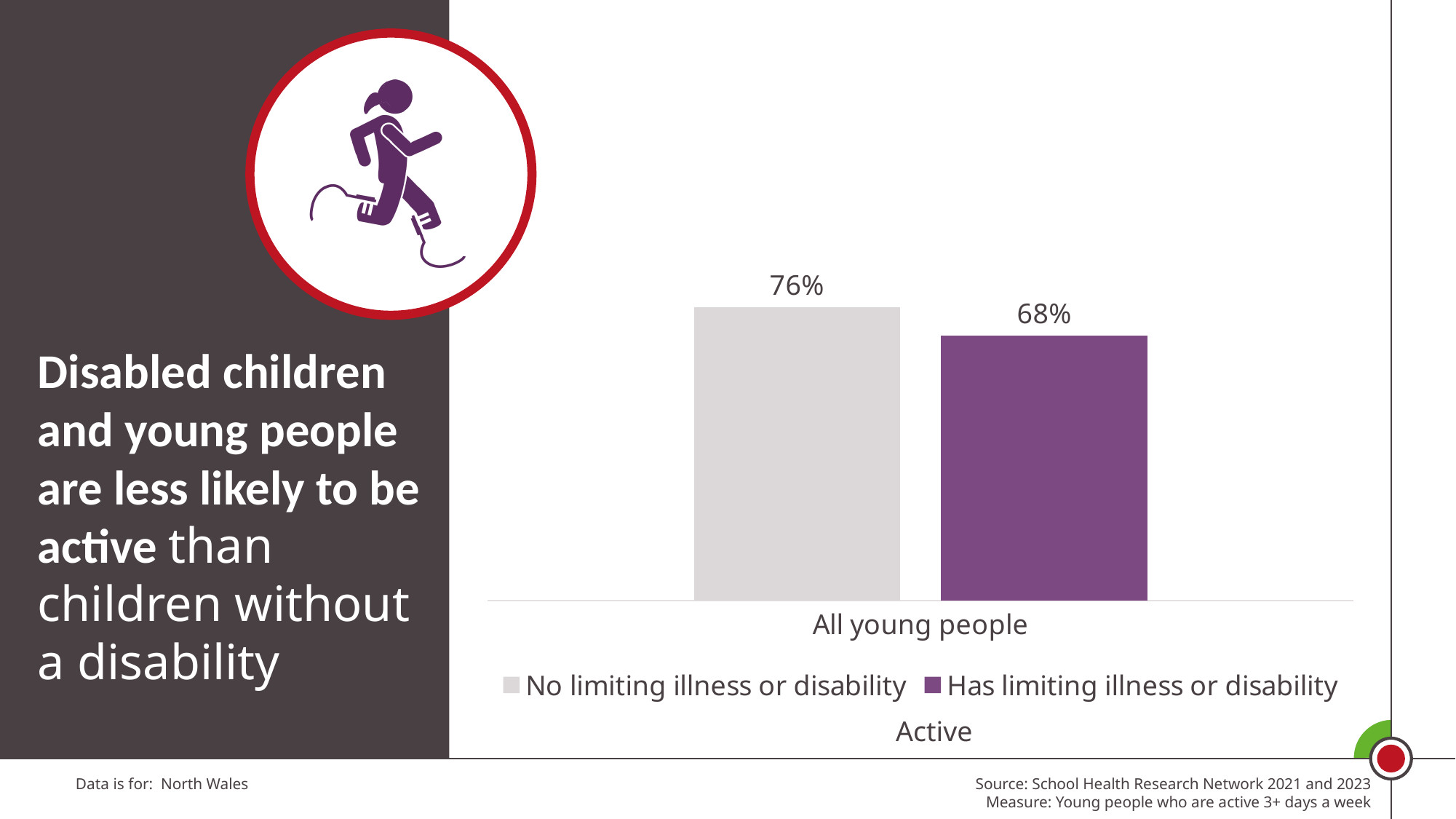
What is the value for 'Has limiting illness or disability' in the Active chart? 68% Which series has the lower value in the Active chart? Has limiting illness or disability Which series has the higher value in the Active chart? No limiting illness or disability What is the value for 'No limiting illness or disability' in the Active chart? 76% How many series does the legend list? 2 What kind of chart is shown on the slide? bar chart How many categories are shown on the x axis? 1 What is the category label on the x axis? All young people What is the title of the chart? Active Is the value for 'No limiting illness or disability' larger or smaller than the value for 'Has limiting illness or disability'? larger What is the difference between the 'No limiting illness or disability' and 'Has limiting illness or disability' values? 8%